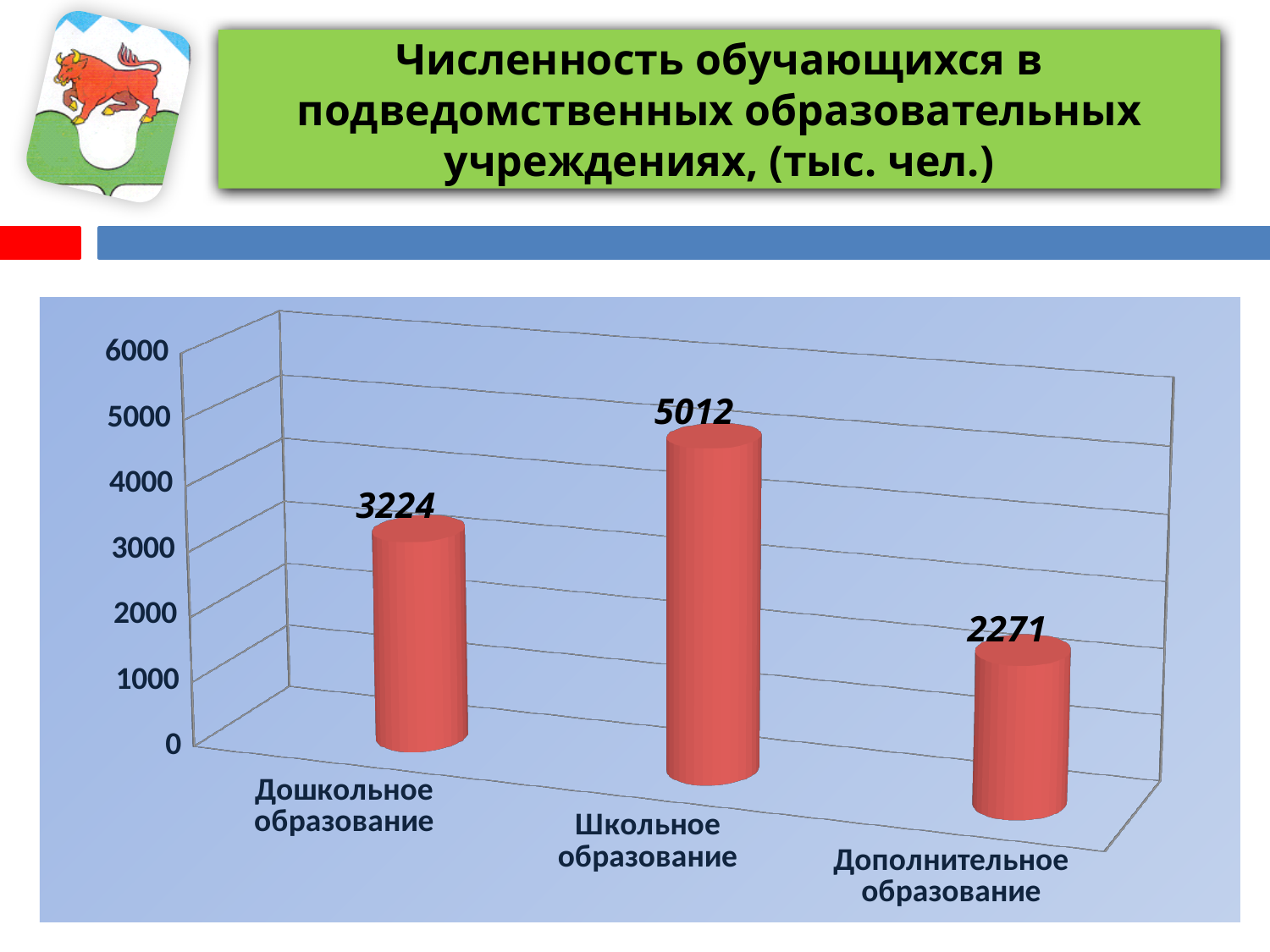
Which category has the highest value? Школьное образование What is the value for Дополнительное образование? 2271 What is the difference between the values for Дошкольное образование and Дополнительное образование? 953 How many categories are shown in the chart? 3 Which is larger, the value for Дошкольное образование or the value for Дополнительное образование? Дошкольное образование Is the value for Школьное образование greater or less than 4000? greater What is the value for Дошкольное образование? 3224 Which category has the lowest value? Дополнительное образование What is the title of the chart on the slide? Численность обучающихся в подведомственных образовательных учреждениях, (тыс. чел.) What is the value for Школьное образование? 5012 What kind of chart is shown on the slide? bar chart What is the difference between the values for Школьное образование and Дошкольное образование? 1788